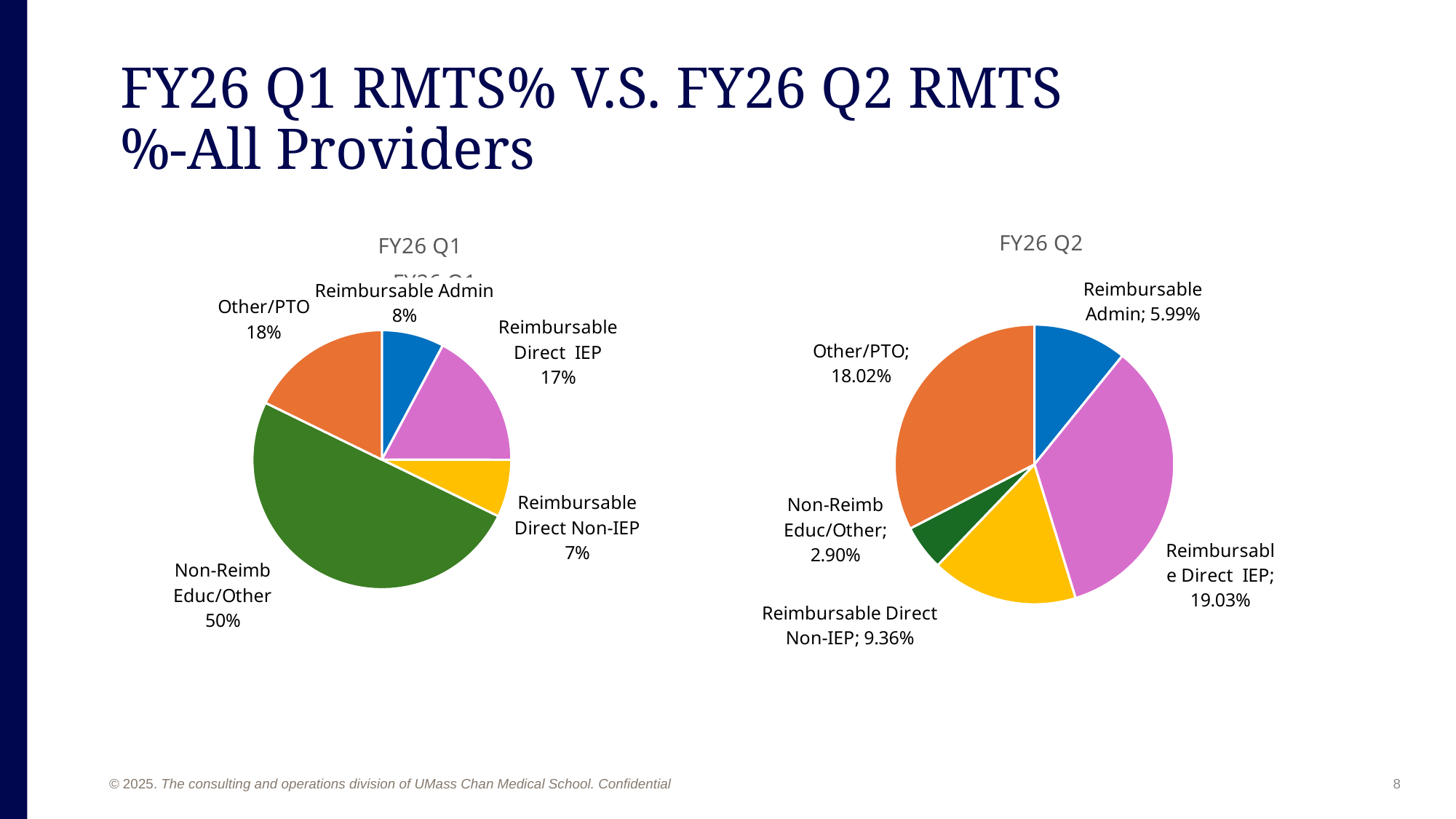
In the FY26 Q2 chart, what is the difference between Reimbursable Direct IEP and Reimbursable Admin? 13.04% What kind of chart is the FY26 Q1 chart? Pie chart In the FY26 Q2 chart, which category has the largest slice? Reimbursable Direct IEP In the FY26 Q1 chart, what is the difference between Other/PTO and Reimbursable Admin? 10% In the FY26 Q2 chart, what is the value for Other/PTO? 18.02% In the FY26 Q1 chart, what is the value for Reimbursable Direct IEP? 17% In the FY26 Q1 chart, which category has the largest slice? Non-Reimb Educ/Other In the FY26 Q2 chart, which category has the smallest slice? Non-Reimb Educ/Other In the FY26 Q1 chart, what is the value for Non-Reimb Educ/Other? 50% In the FY26 Q2 chart, what is the value for Reimbursable Direct Non-IEP? 9.36% How many categories does the FY26 Q2 chart show? 5 In the FY26 Q1 chart, which is larger: Reimbursable Admin or Reimbursable Direct Non-IEP? Reimbursable Admin